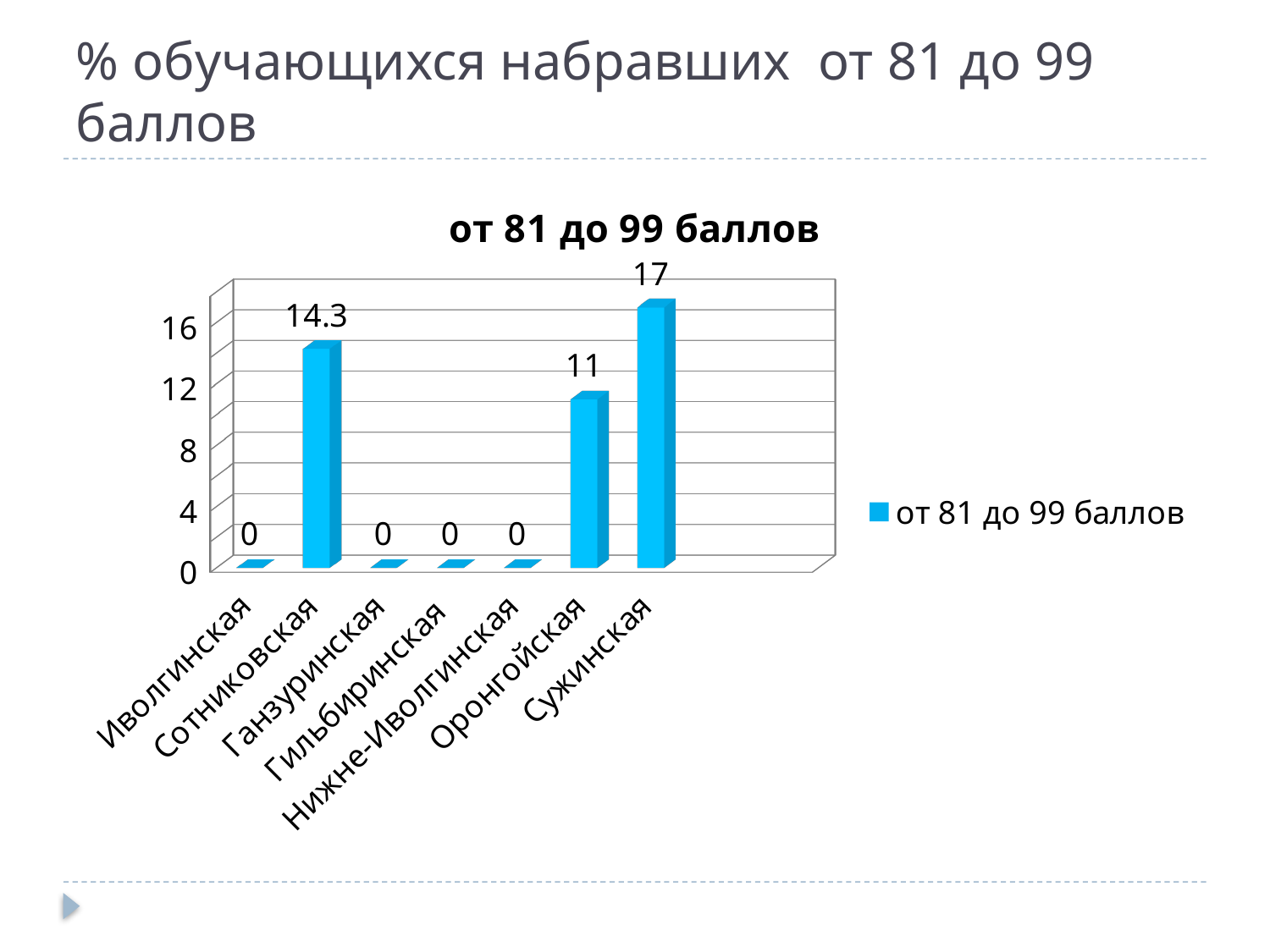
Which is larger, the value for Сотниковская or the value for Оронгойская? Сотниковская What is the value for Сужинская? 17 What is the difference between the values for Сотниковская and Оронгойская? 3.3 What is the difference between the values for Сужинская and Сотниковская? 2.7 How many categories are shown on the x axis? 7 What is the title of the chart? от 81 до 99 баллов What kind of chart is shown? bar chart Which category has the highest value? Сужинская What is the value for Сотниковская? 14.3 What is the value for Иволгинская? 0 What is the value for Оронгойская? 11 How many categories have a value of 0? 4